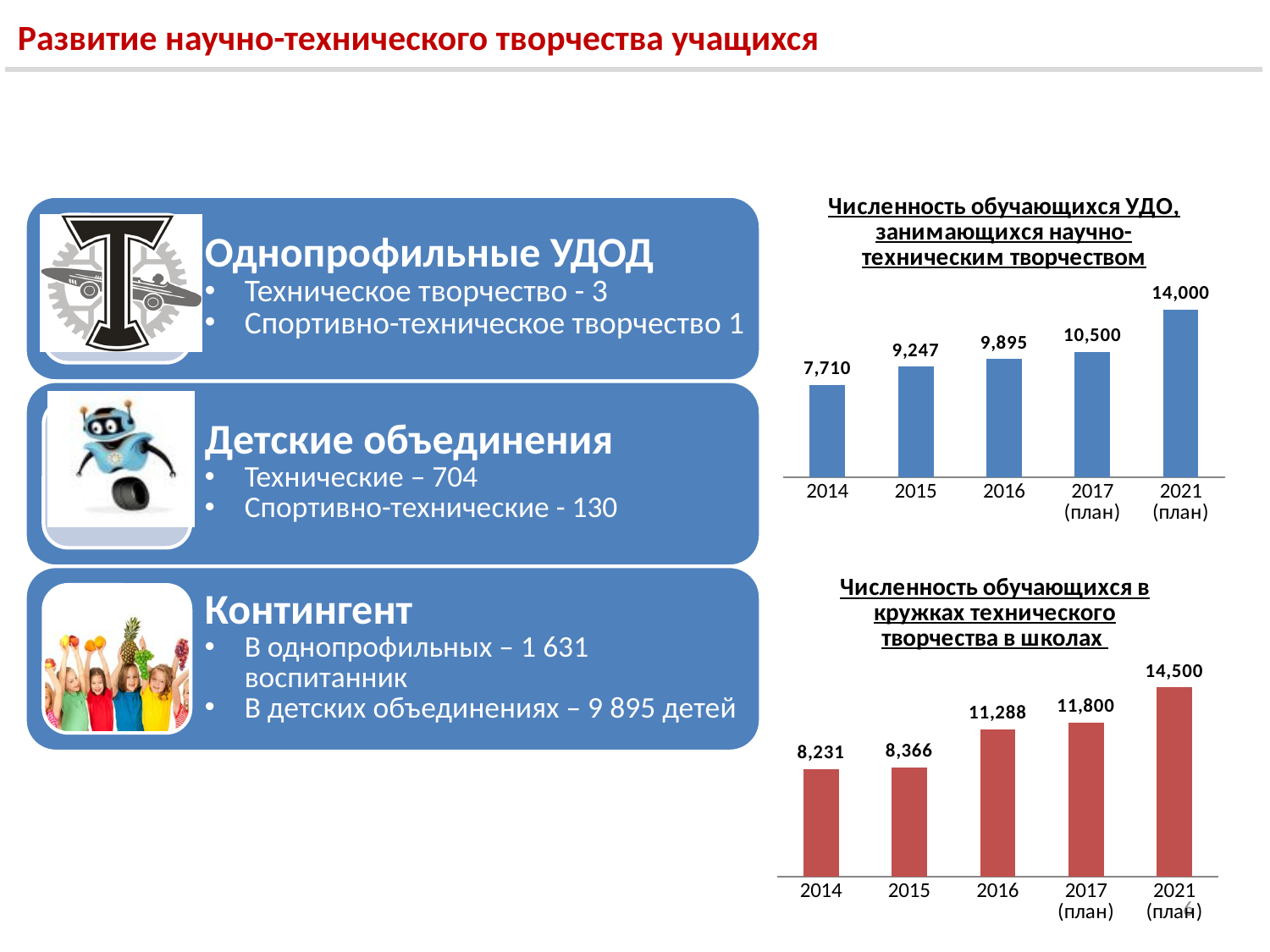
In the top chart (Численность обучающихся УДО), what is the value for 2017 (план)? 10,500 In the top chart (Численность обучающихся УДО), what is the value for 2014? 7,710 In the top chart (Численность обучающихся УДО), which year has the highest value? 2021 (план) In the top chart (Численность обучающихся УДО), do the values rise or fall from 2014 to 2021 (план)? rise In the bottom chart (Численность обучающихся в кружках технического творчества в школах), what is the value for 2016? 11,288 In the bottom chart (Численность обучающихся в кружках технического творчества в школах), what is the value for 2021 (план)? 14,500 In the top chart (Численность обучающихся УДО), how many bars are plotted? 5 In the bottom chart (Численность обучающихся в кружках технического творчества в школах), what is the difference between the values for 2021 (план) and 2017 (план)? 2,700 What type of chart is the bottom chart on the slide? bar chart In the top chart (Численность обучающихся УДО), what is the difference between the values for 2016 and 2015? 648 Which is larger: the 2014 value in the top chart or the 2014 value in the bottom chart? the bottom chart (8,231) In the bottom chart (Численность обучающихся в кружках технического творчества в школах), which year has the lowest value? 2014